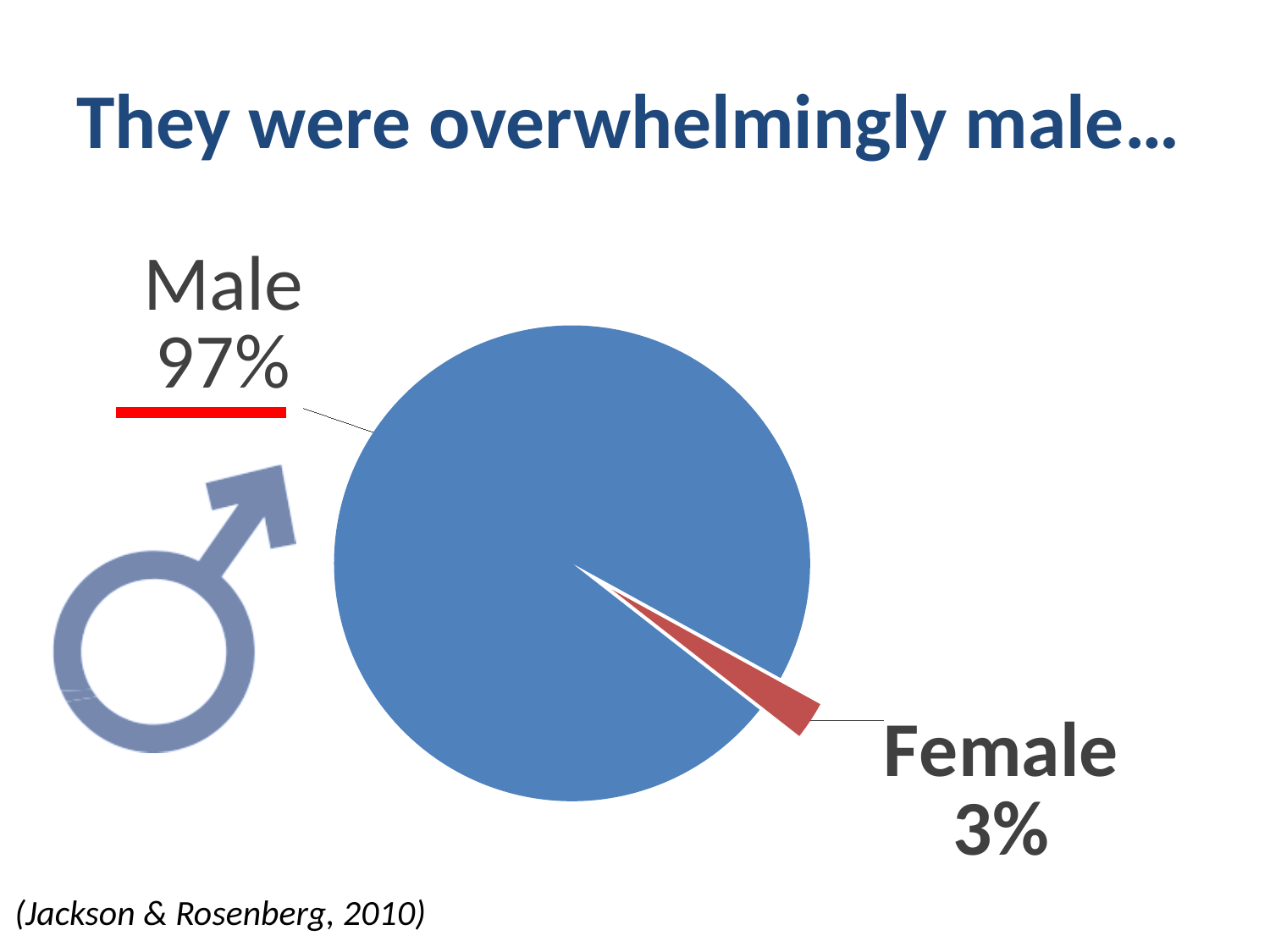
Which slice of the pie is the smallest? Female What percentage of the pie is labelled Female? 3% What is the difference in percentage points between the Male and Female slices? 94 What colour is the Female slice of the pie? red How many slices does the pie chart have? 2 Which slice of the pie is the largest? Male Which slice is larger, Male or Female? Male What percentage of the pie is labelled Male? 97% What share of the pie does the Female slice represent? 3% What kind of chart is shown on the slide? pie chart What is the title of the slide containing the pie chart? They were overwhelmingly male…